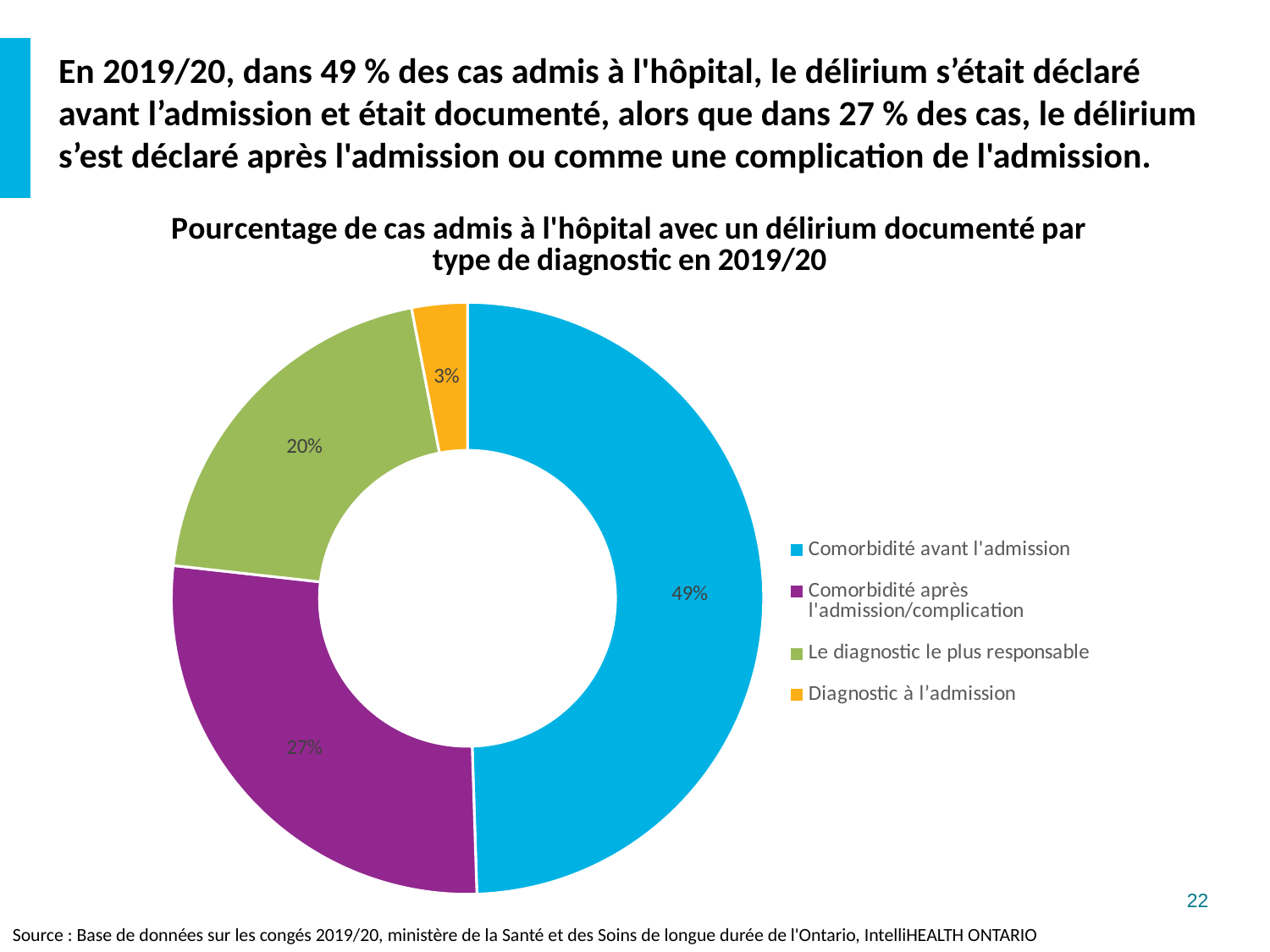
What is the difference in percentage points between 'Comorbidité avant l'admission' and 'Comorbidité après l'admission/complication'? 22 Which diagnosis type has the smallest share of the chart? Diagnostic à l’admission What is the title of the chart? Pourcentage de cas admis à l'hôpital avec un délirium documenté par type de diagnostic en 2019/20 What percentage of cases is shown for 'Comorbidité avant l'admission'? 49% What colour represents 'Comorbidité après l'admission/complication' in the chart? Purple Which is larger: the share for 'Le diagnostic le plus responsable' or the share for 'Diagnostic à l’admission'? Le diagnostic le plus responsable Which diagnosis type has the largest share of the chart? Comorbidité avant l'admission What kind of chart is shown on the slide? Doughnut (pie) chart How many categories are shown in the chart? 4 What percentage of cases is shown for 'Comorbidité après l'admission/complication'? 27% What percentage of cases is shown for 'Le diagnostic le plus responsable'? 20% What percentage of cases is shown for 'Diagnostic à l’admission'? 3%